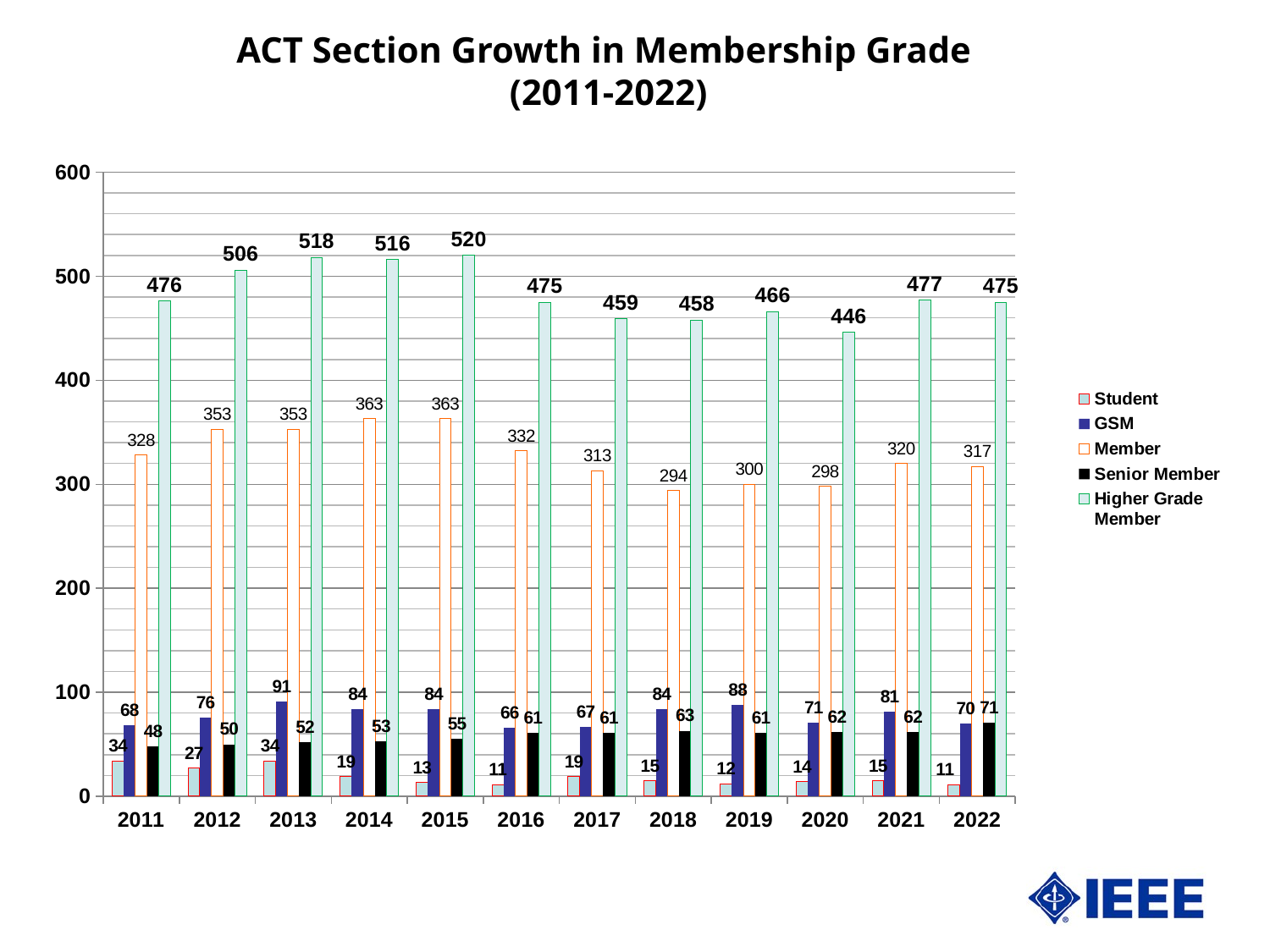
Which year has the larger GSM value, 2013 or 2019? 2013 What is the value for Senior Member in 2022? 71 How many years are shown on the x axis? 12 Does the Student value generally rise or fall from 2011 to 2022? Fall In which year is the Higher Grade Member value the highest? 2015 In which year is the Member value the lowest? 2018 What is the value for Member in 2018? 294 What kind of chart is shown on the slide? Bar chart How many series does the legend list? 5 What is the difference between the Higher Grade Member values in 2013 and 2011? 42 What is the value for Higher Grade Member in 2015? 520 What is the title of the chart? ACT Section Growth in Membership Grade (2011-2022)